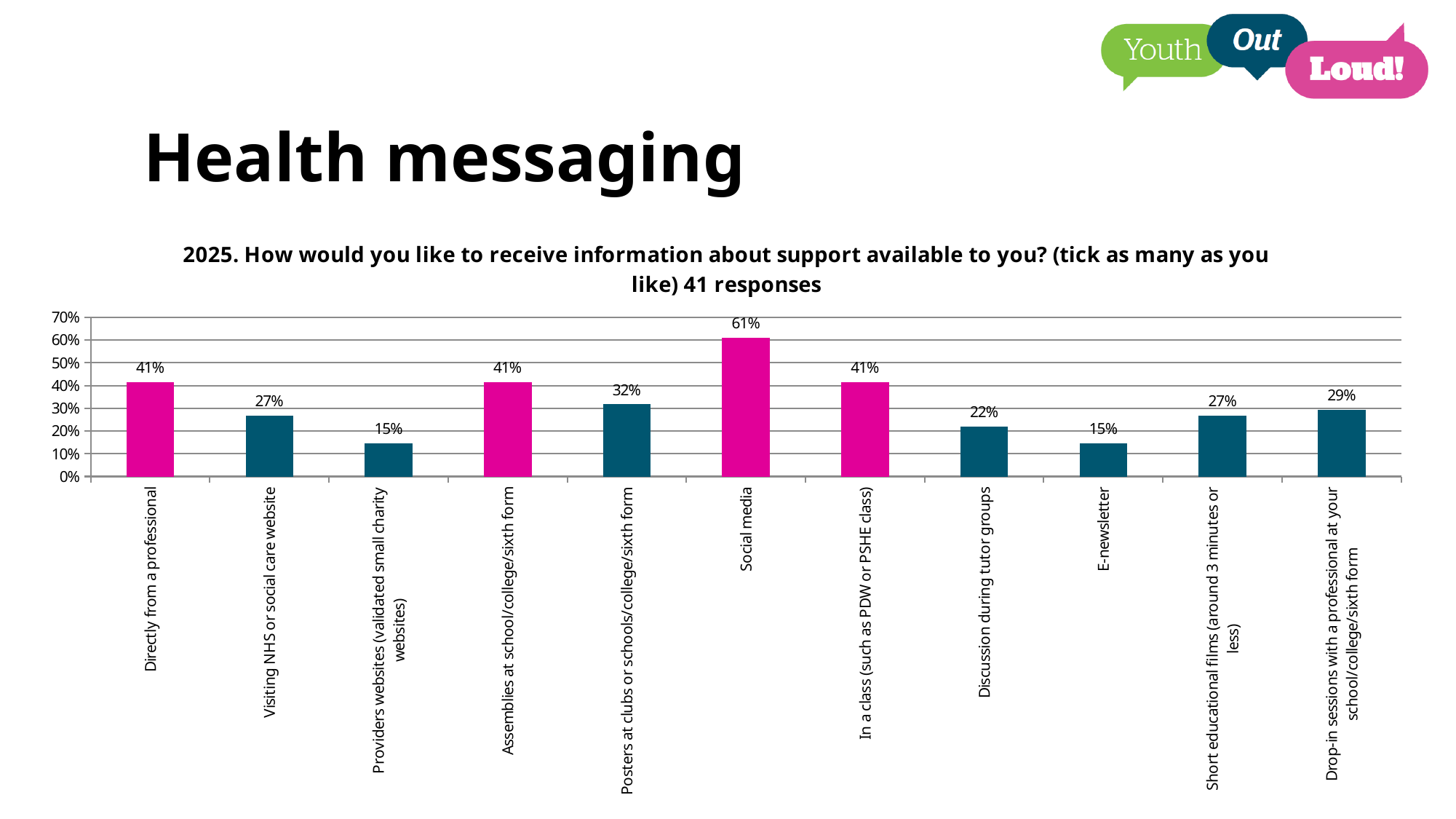
What percentage of respondents chose Social media? 61% What is the value for Posters at clubs or schools/college/sixth form? 32% How many categories are shown on the chart? 11 What kind of chart is this? Bar chart Which category has the highest value? Social media What percentage chose Drop-in sessions with a professional at your school/college/sixth form? 29% Is the value for Social media greater or less than 50%? greater What is the lowest value shown on the chart? 15% How many responses does the chart title say were received? 41 What is the value for Discussion during tutor groups? 22% What is the difference between Social media and Directly from a professional? 20% Which is larger: Posters at clubs or schools/college/sixth form or E-newsletter? Posters at clubs or schools/college/sixth form